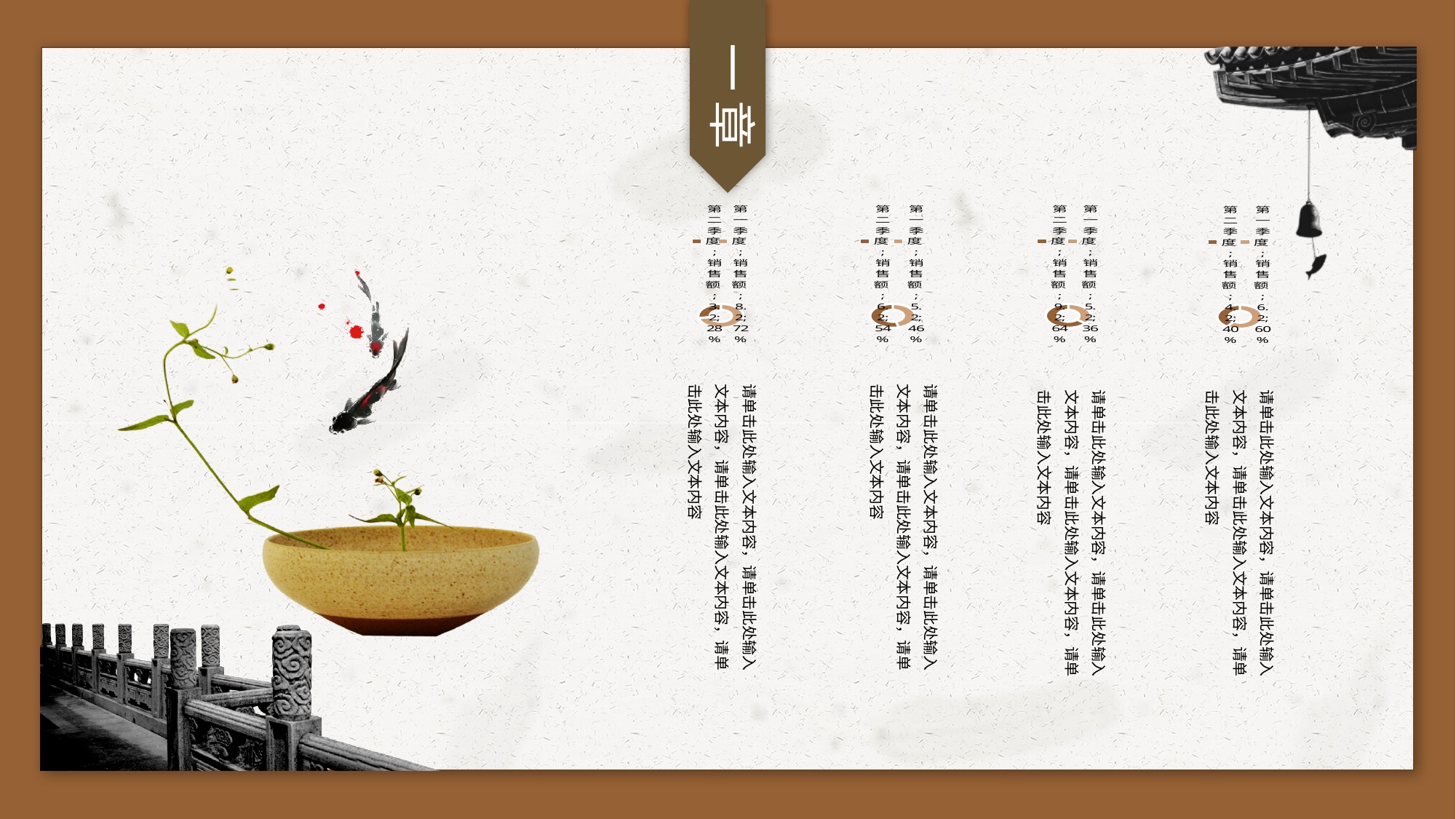
In the leftmost chart, which quarter has the larger share? 第一季度 In the leftmost chart, what percentage is shown for 第一季度? 72% In the second chart from the left, what percentage is shown for 第二季度? 54% What kind of chart is the leftmost chart on the slide? doughnut chart In the second chart from the left, what percentage is shown for 第一季度? 46% How many charts are shown on the slide? 4 In the third chart from the left, what percentage is shown for 第二季度? 64% In the rightmost chart, what percentage is shown for 第一季度? 60% In the third chart from the left, which quarter has the smaller share? 第一季度 In the rightmost chart, what is the difference in percentage points between 第一季度 and 第二季度? 20 In the leftmost chart, what percentage is shown for 第二季度? 28% How many categories does each doughnut chart on the slide have? 2